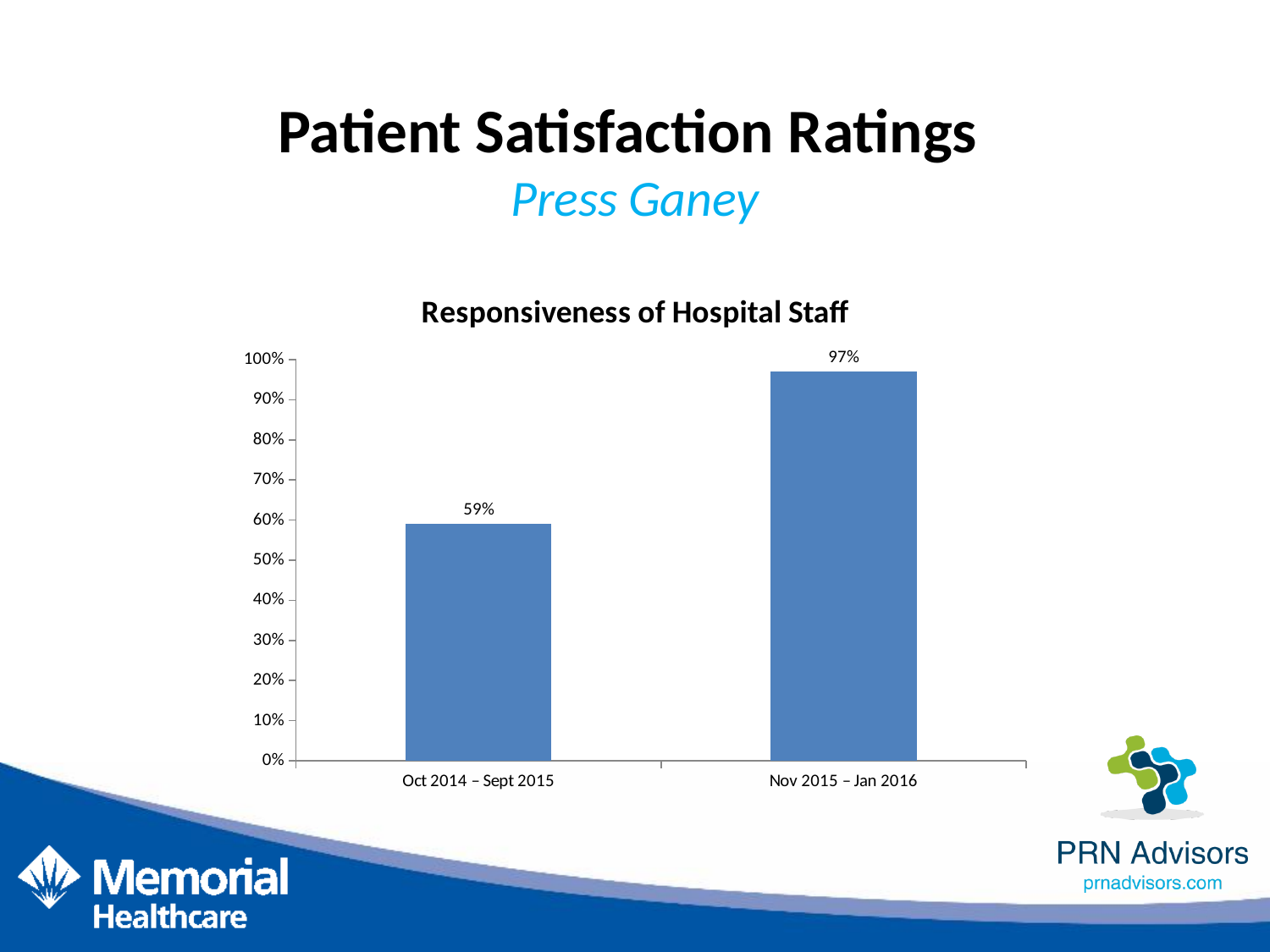
What kind of chart is shown on the slide? bar chart What is the value for Oct 2014 – Sept 2015? 59% Is the value for Nov 2015 – Jan 2016 greater or less than 90%? greater Which period has the highest value? Nov 2015 – Jan 2016 What is the difference between the values for Nov 2015 – Jan 2016 and Oct 2014 – Sept 2015? 38% Is the value for Oct 2014 – Sept 2015 greater or less than 50%? greater Which period has the lowest value? Oct 2014 – Sept 2015 What is the value for Nov 2015 – Jan 2016? 97% How many categories are shown on the x axis? 2 Which is larger, the value for Oct 2014 – Sept 2015 or the value for Nov 2015 – Jan 2016? Nov 2015 – Jan 2016 Do the values rise or fall from left to right along the x axis? rise What is the title of the chart? Responsiveness of Hospital Staff